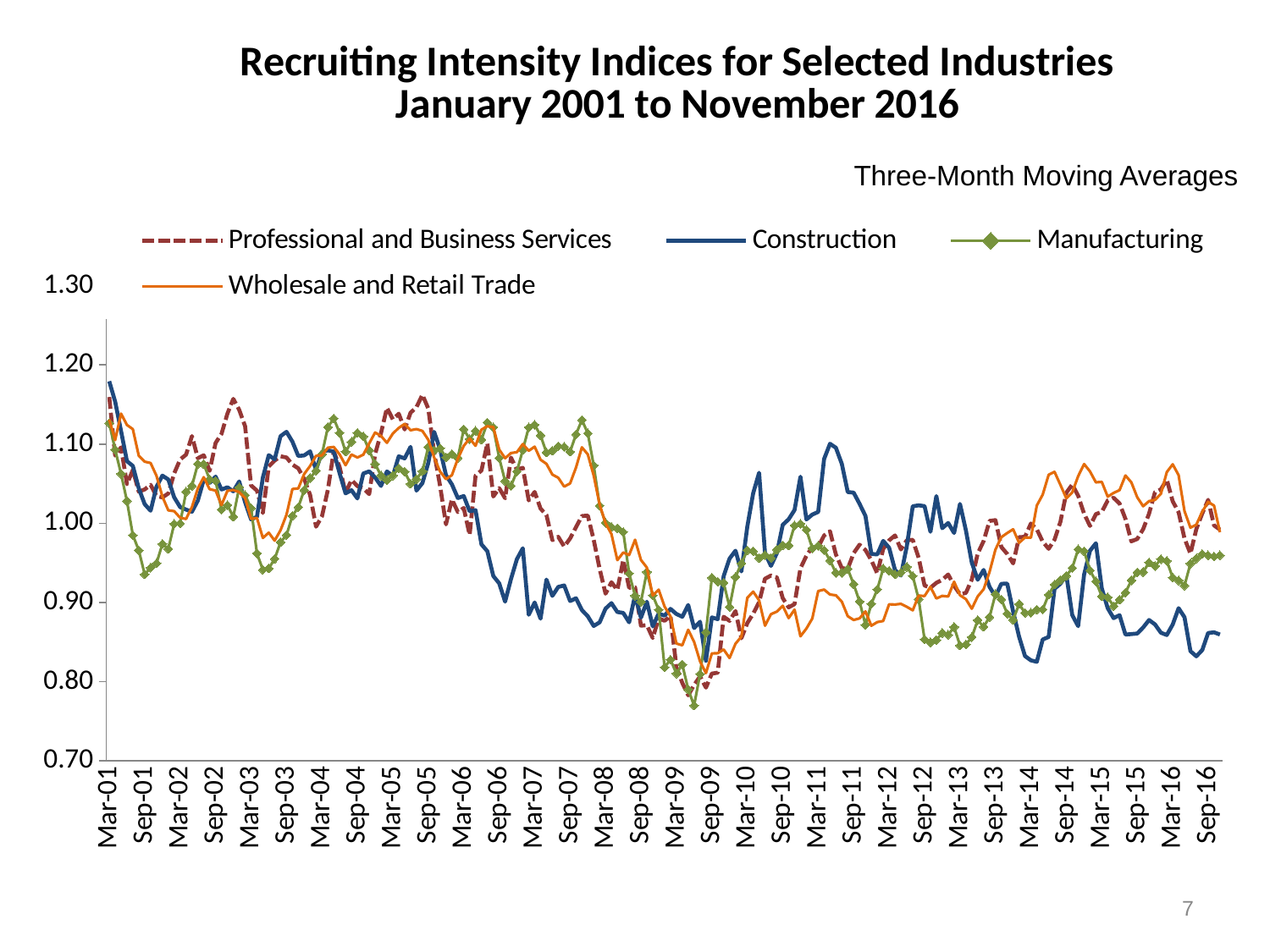
Which series has the lowest value at Mar-14? Construction How many series does the legend list? 4 At Sep-16, which is higher: Wholesale and Retail Trade or Construction? Wholesale and Retail Trade Does the Construction series rise or fall overall from Mar-01 to Sep-16? Fall Is the value for Professional and Business Services at Sep-05 greater or less than 1.10? greater Is the value for Construction at Mar-14 greater or less than 0.90? less Which series is drawn with a dashed line? Professional and Business Services Is the value for Construction at Sep-16 greater or less than 0.90? less What is the title of the chart? Recruiting Intensity Indices for Selected Industries January 2001 to November 2016 What kind of chart is shown on the slide? Line chart